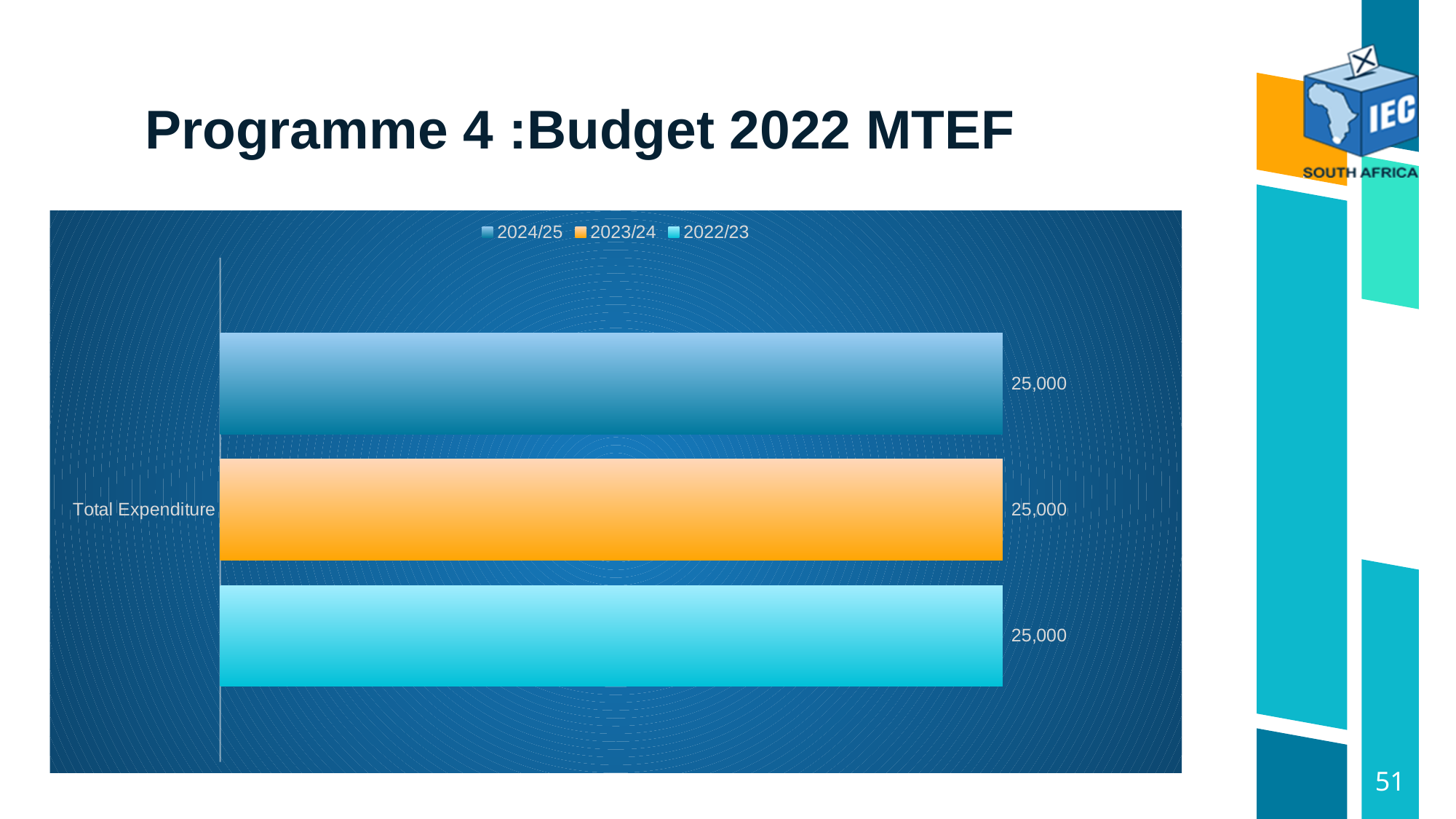
What is the title of the slide containing the chart? Programme 4 :Budget 2022 MTEF How many series does the legend list? 3 What is the value for Total Expenditure in the 2023/24 series? 25,000 How many categories are shown on the chart? 1 What is the value for Total Expenditure in the 2024/25 series? 25,000 What is the difference between the 2024/25 and 2022/23 values for Total Expenditure? 0 Which series is shown in orange in the legend? 2023/24 What kind of chart is shown on the slide? Bar chart What is the value for Total Expenditure in the 2022/23 series? 25,000 What is the name of the category shown on the chart? Total Expenditure